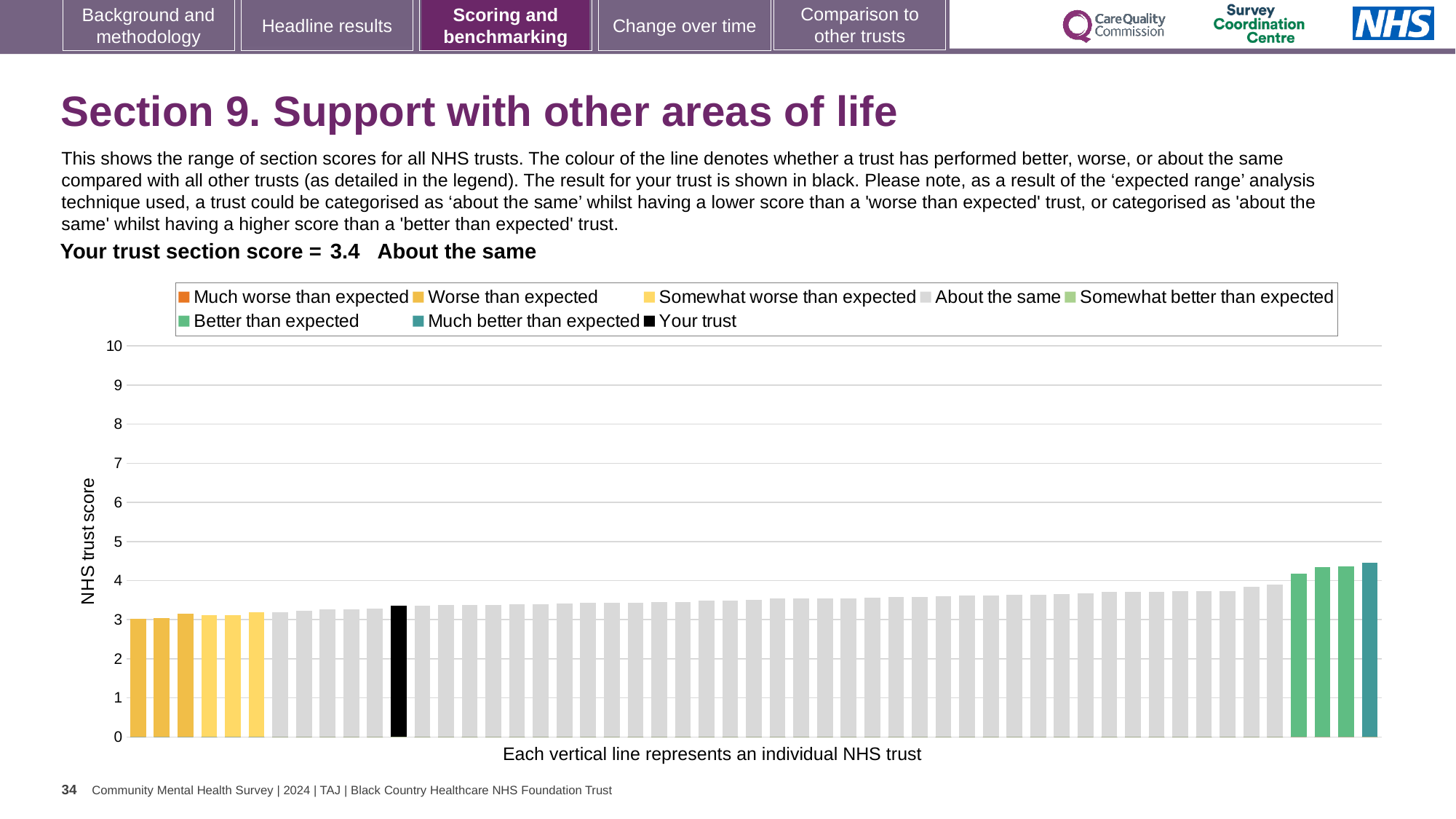
What is the label on the vertical axis of the chart? NHS trust score Is the value of the highest bar greater or less than 5? less What colour is the bar representing your trust? black Do the bar values rise or fall from left to right across the chart? rise Is the value of the lowest bar greater or less than 4? less How many entries does the chart legend list? 8 Is the value of the highest bar greater or less than 4? greater What kind of chart is shown on the slide? bar chart How many bars at the left of the chart are coloured yellow? 6 What is the section score for your trust shown on the slide? 3.4 How is your trust's section score categorised compared with other trusts? About the same How many bars at the right of the chart are coloured green or teal? 4